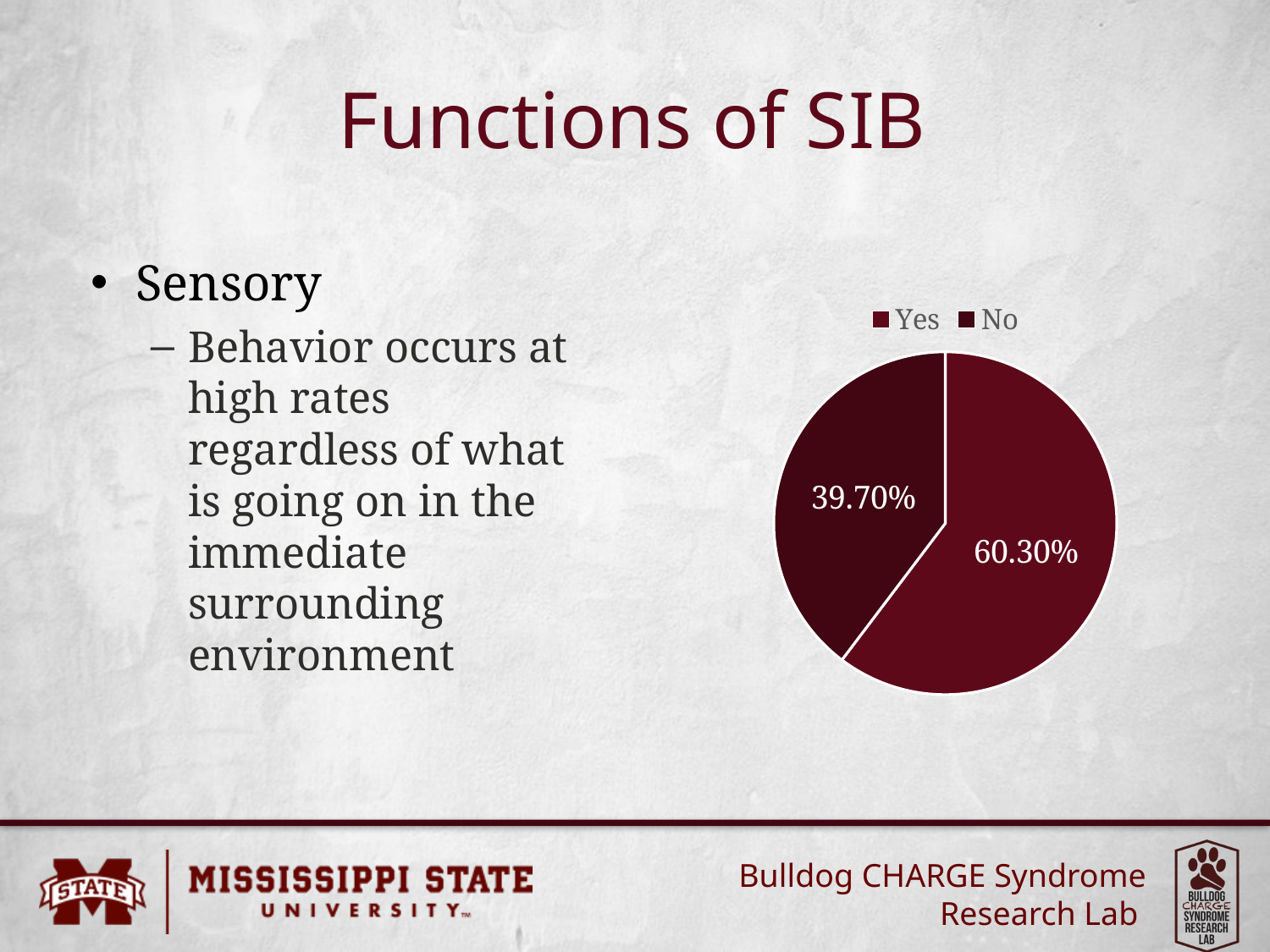
What share of the pie does the No slice represent? 39.70% What percentage of the pie chart is labelled for the Yes slice? 60.30% Is the Yes slice of the pie chart greater or less than half of the pie? greater What is the difference in percentage points between the Yes and No slices? 20.60 What percentage of the pie chart is labelled for the No slice? 39.70% How many entries does the pie chart's legend list? 2 Which slice of the pie chart is the smallest? No Which slice of the pie chart is the largest? Yes What kind of chart is shown on the slide? Pie chart How many slices does the pie chart have? 2 Which is larger in the pie chart, the Yes slice or the No slice? Yes What are the two legend entries of the pie chart? Yes and No